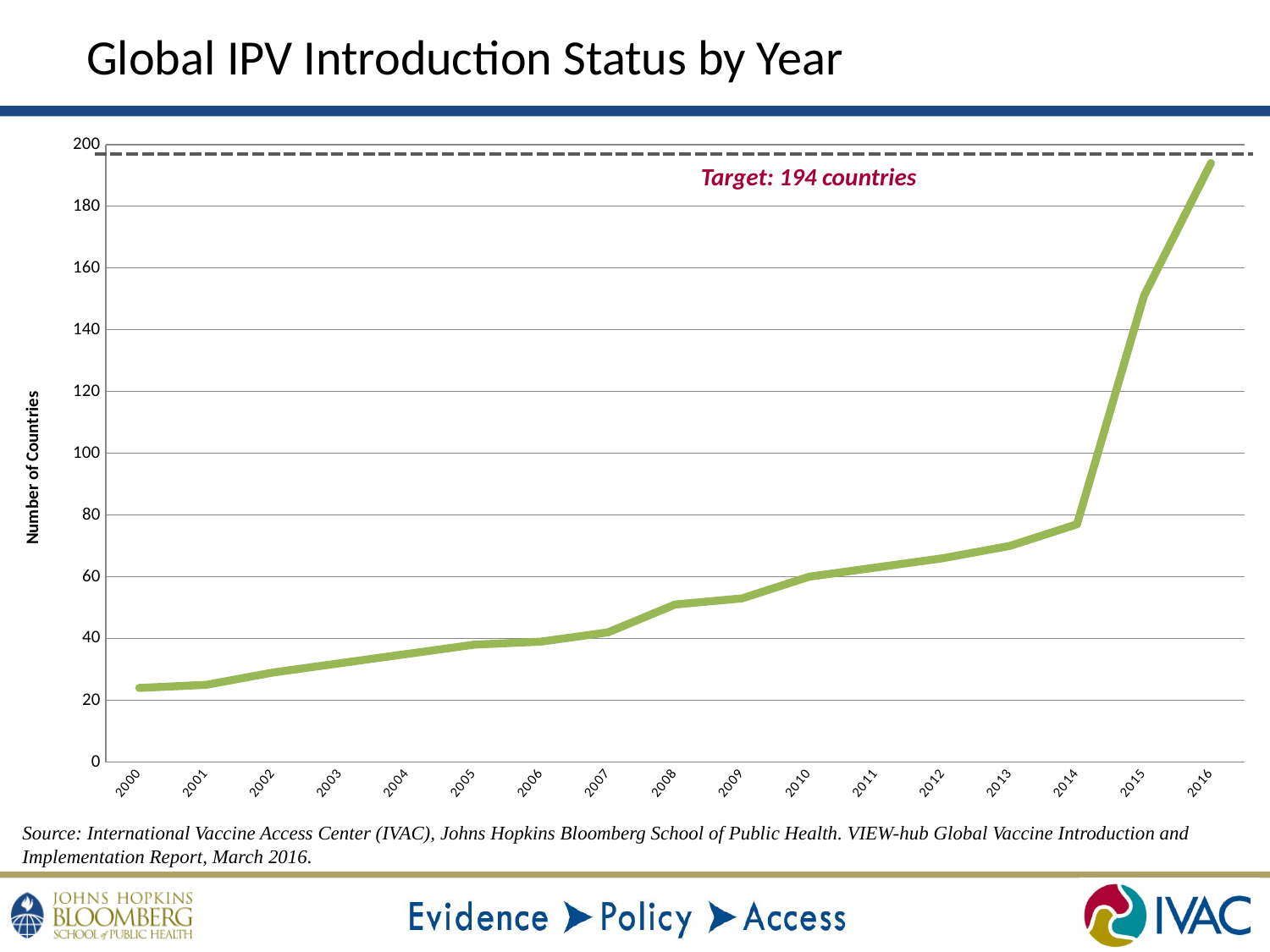
Is the value for 2014 greater or less than 80? less What kind of chart is shown on the slide? line chart Which year has the lowest number of countries? 2000 Is the value for 2000 greater or less than 40? less Which year has the highest number of countries? 2016 What target number of countries is marked by the dashed line? 194 countries What is the label of the y axis? Number of Countries Which year has the larger value, 2015 or 2013? 2015 Is the value for 2016 greater or less than 180? greater Do the values rise or fall from 2000 to 2016? rise How many years are plotted along the x axis? 17